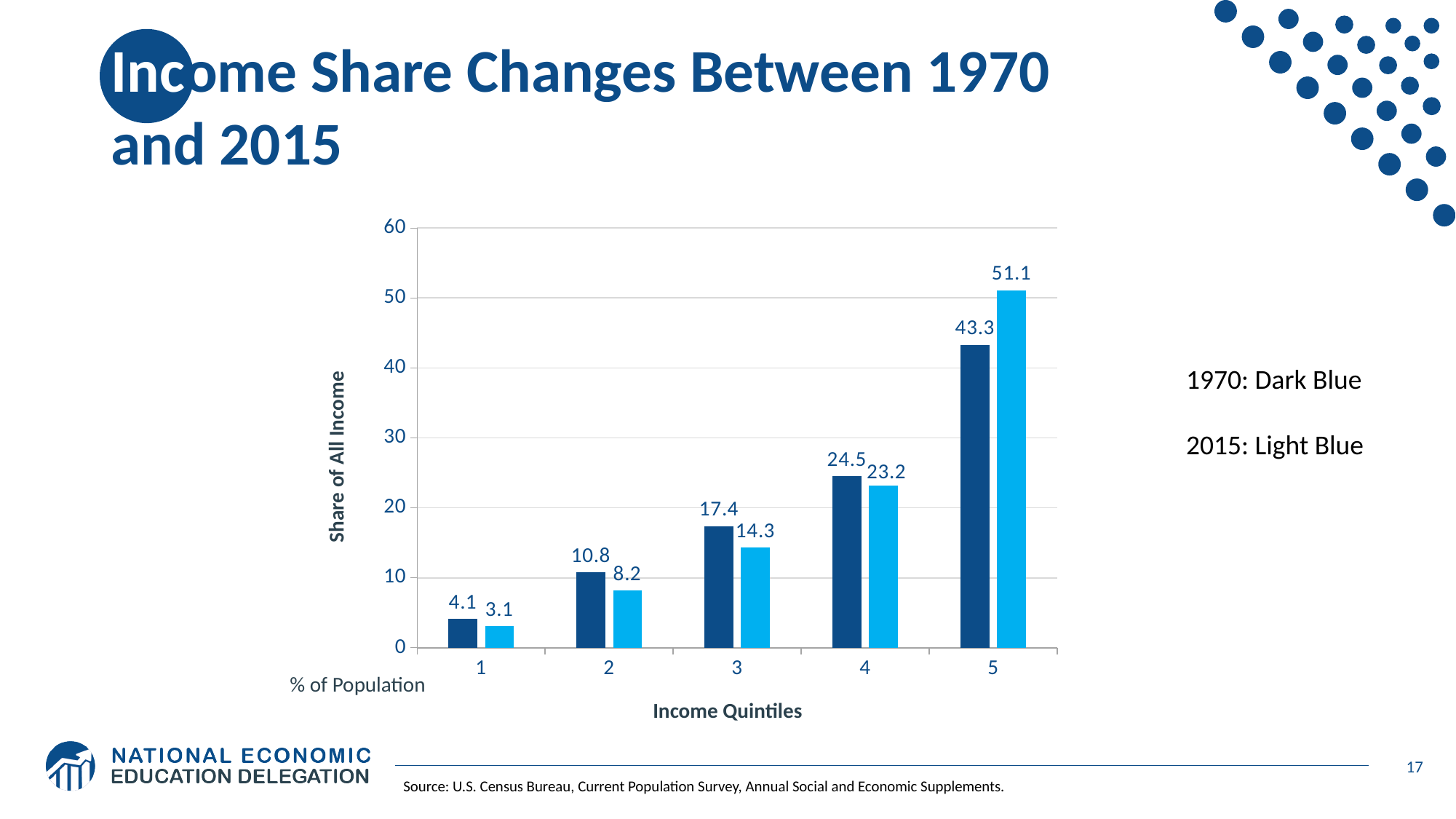
How many data series (years) does the chart show? 2 Which income quintile has the lowest 1970 income share? 1 What is the difference between the 1970 and 2015 income shares for quintile 3? 3.1 What is the 2015 income share for income quintile 2? 8.2 Which income quintile has the highest 2015 income share? 5 What is the 1970 income share for income quintile 5? 43.3 Which colour represents the year 2015 in the chart? Light blue For income quintile 4, which year has the larger income share, 1970 or 2015? 1970 What is the 2015 income share for income quintile 1? 3.1 How many income quintiles are shown on the x axis? 5 What is the difference between the 2015 and 1970 income shares for quintile 5? 7.8 What kind of chart is shown on the slide? Bar chart